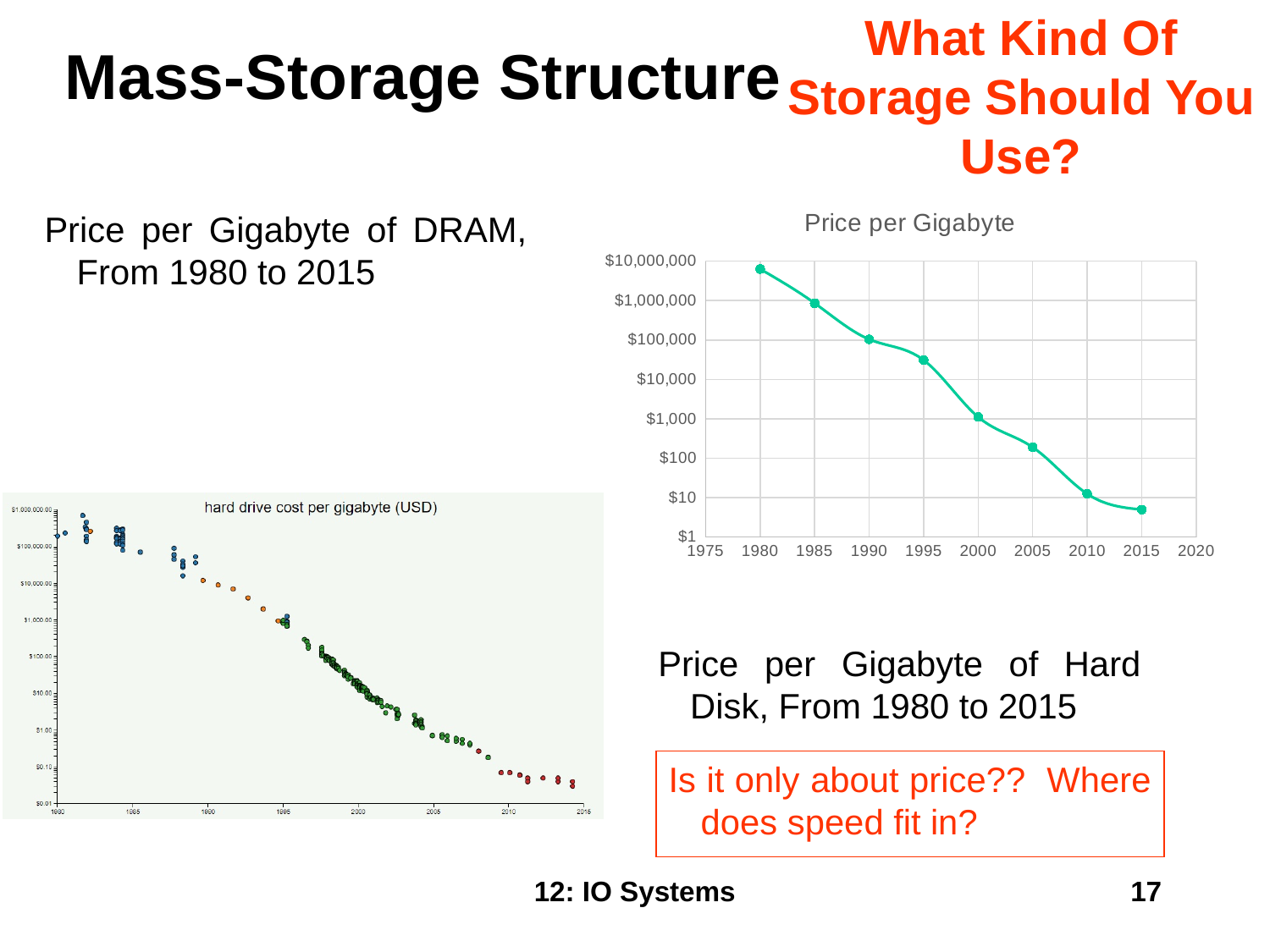
In the 'Price per Gigabyte' line chart, is the value for 1980 greater or less than $1,000,000? greater In the 'Price per Gigabyte' line chart, which year has the lowest price? 2015 In the 'Price per Gigabyte' line chart, is the value for 1995 greater or less than $10,000? greater In the 'Price per Gigabyte' line chart, do the values rise or fall as the year increases? fall What kind of chart is the 'hard drive cost per gigabyte (USD)' chart on the bottom left of the slide? scatter chart In the 'Price per Gigabyte' line chart, which year has the highest price? 1980 In the 'Price per Gigabyte' line chart, which is larger, the value for 1990 or the value for 2000? 1990 In the 'Price per Gigabyte' line chart, is the value for 2015 greater or less than $10? less In the 'hard drive cost per gigabyte (USD)' scatter chart, do the values rise or fall as the year increases? fall What kind of chart is the 'Price per Gigabyte' chart on the right of the slide? line chart In the 'Price per Gigabyte' line chart, how many data points are plotted? 8